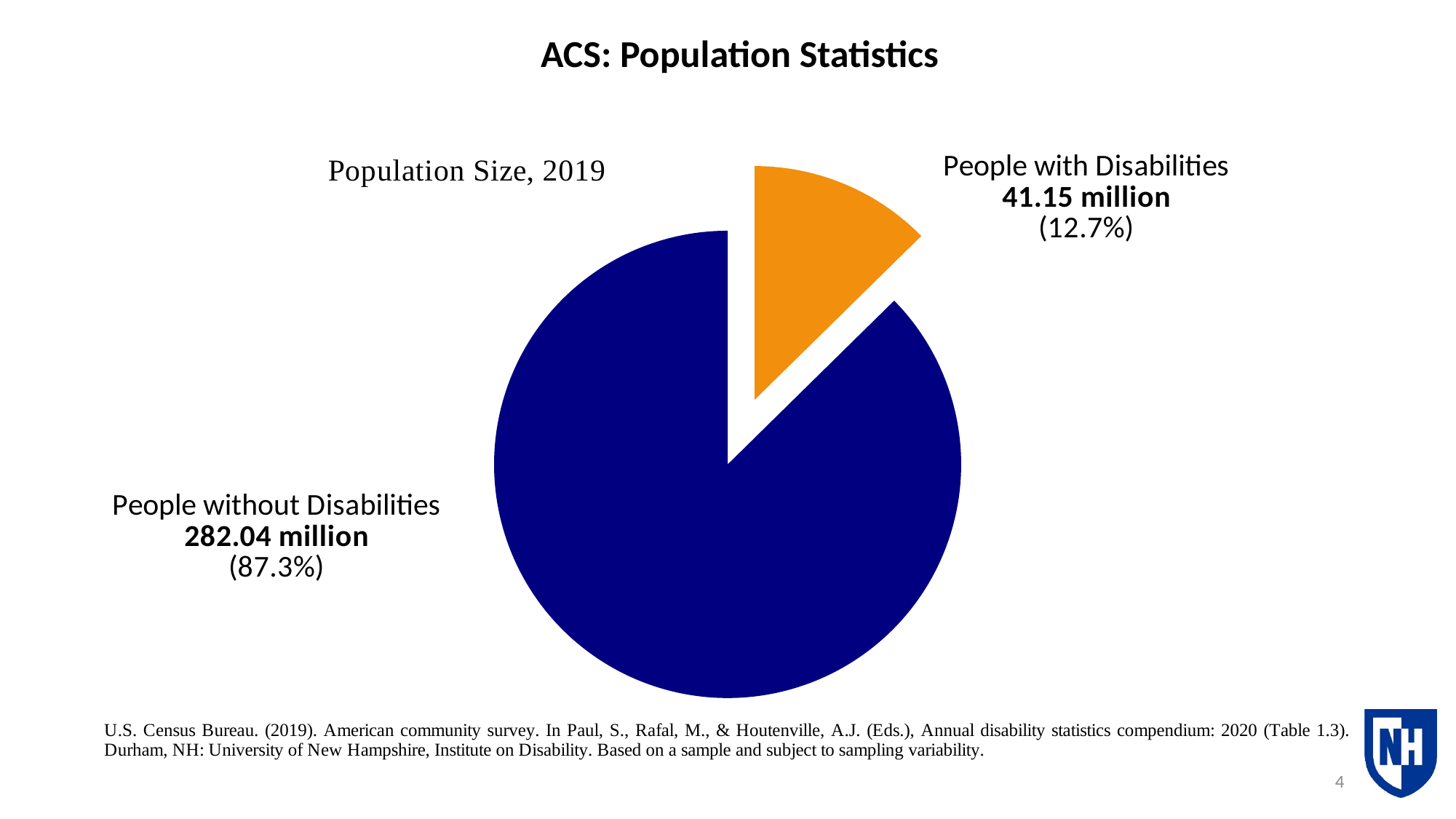
What share of the pie is People with Disabilities? 12.7% What colour is the People with Disabilities slice? orange How many slices does the pie chart have? 2 What is the value for People with Disabilities? 41.15 million What kind of chart is shown on the slide? pie chart Which slice is the smallest? People with Disabilities Which slice is the largest? People without Disabilities What is the difference in millions between People without Disabilities and People with Disabilities? 240.89 million What is the value for People without Disabilities? 282.04 million Which is larger, People with Disabilities or People without Disabilities? People without Disabilities What share of the pie is People without Disabilities? 87.3% What is the chart's title? Population Size, 2019